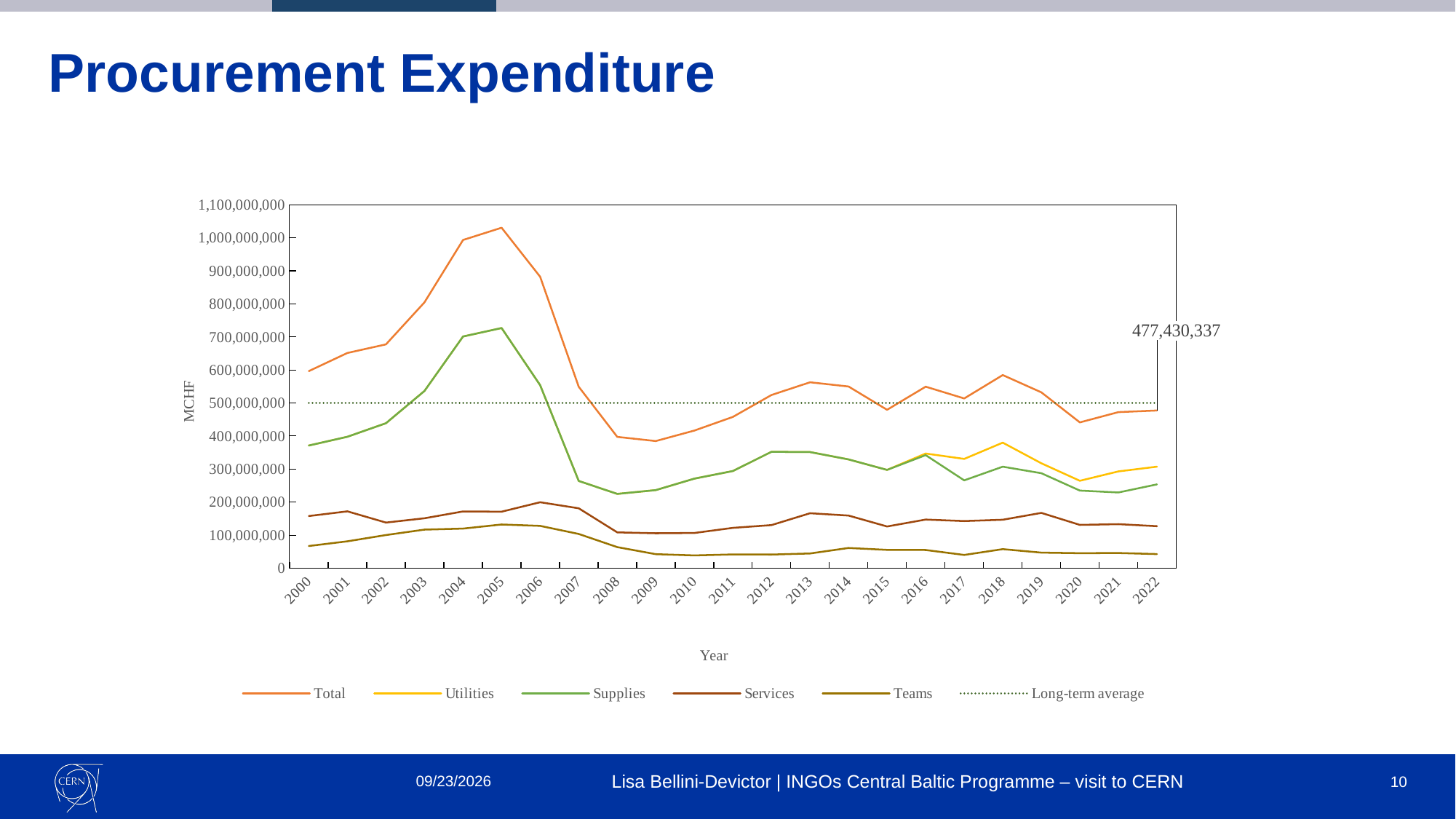
How many years are shown on the x axis? 23 Is the value for Total in 2020 greater or less than 500,000,000? less What is the value of Total in 2022? 477,430,337 Is the value for Supplies in 2008 greater or less than 300,000,000? less In which year is the Supplies series at its highest? 2005 In which year is the Total series at its highest? 2005 What is the label on the y axis? MCHF How many series does the legend list? 6 What kind of chart is shown on the slide? line chart Does the Total series rise or fall from 2000 to 2005? rise Is the value for Total in 2005 greater or less than 1,000,000,000? greater Which is larger in 2018, Utilities or Supplies? Utilities